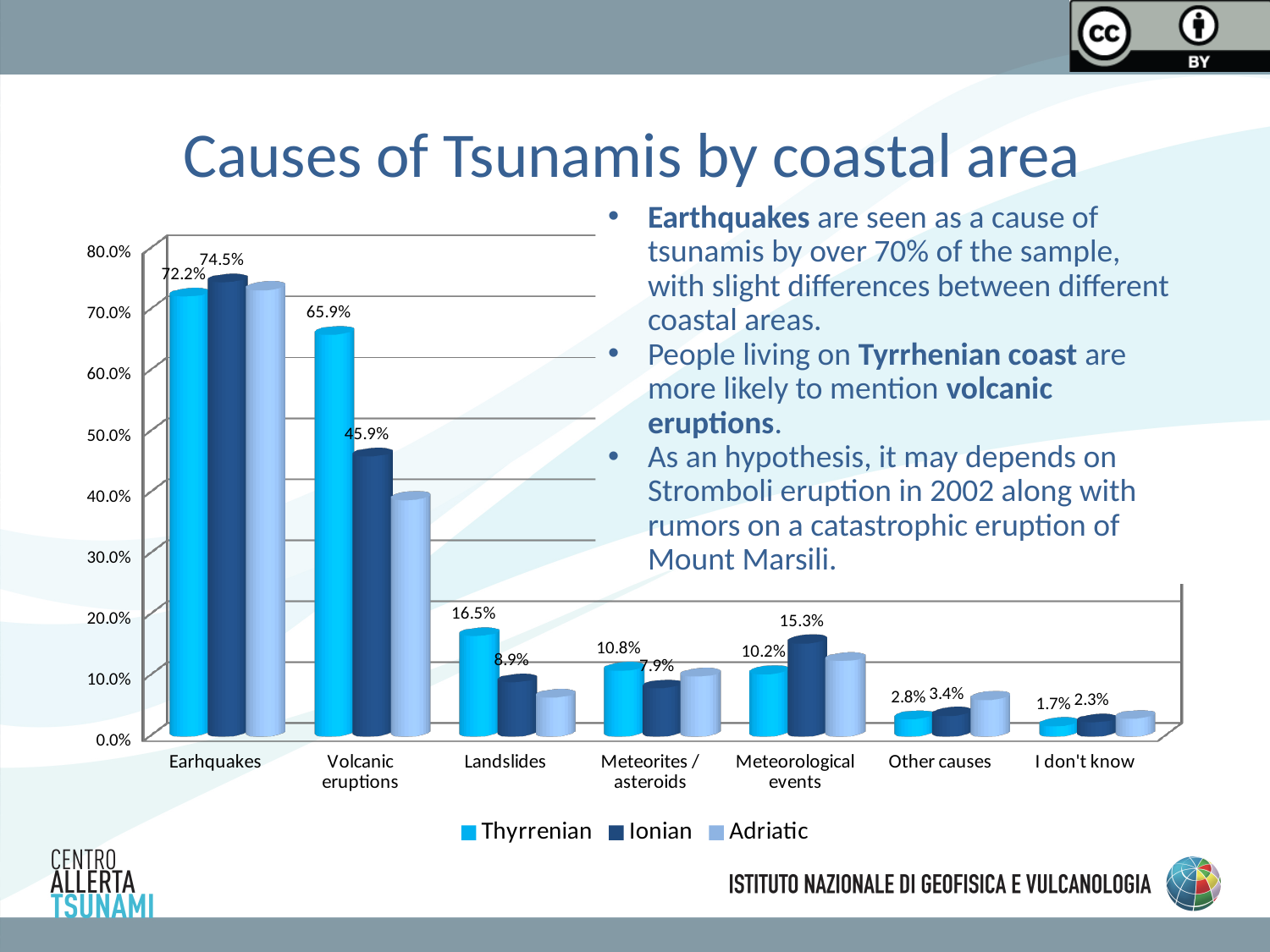
For Meteorological events, which is larger: the Thyrrenian value or the Ionian value? Ionian Which category has the highest Thyrrenian value? Earthquakes Which category has the lowest Ionian value? I don't know What are the three series named in the legend? Thyrrenian, Ionian, Adriatic What is the difference between the Thyrrenian and Ionian values for Volcanic eruptions? 20.0% How many cause categories are shown on the x axis? 7 What is the Ionian value for Earthquakes? 74.5% How many series does the legend list? 3 What is the Thyrrenian value for Volcanic eruptions? 65.9% Is the Adriatic value for Landslides greater or less than 10.0%? less What is the Ionian value for Landslides? 8.9% What kind of chart is shown on the slide? Bar chart